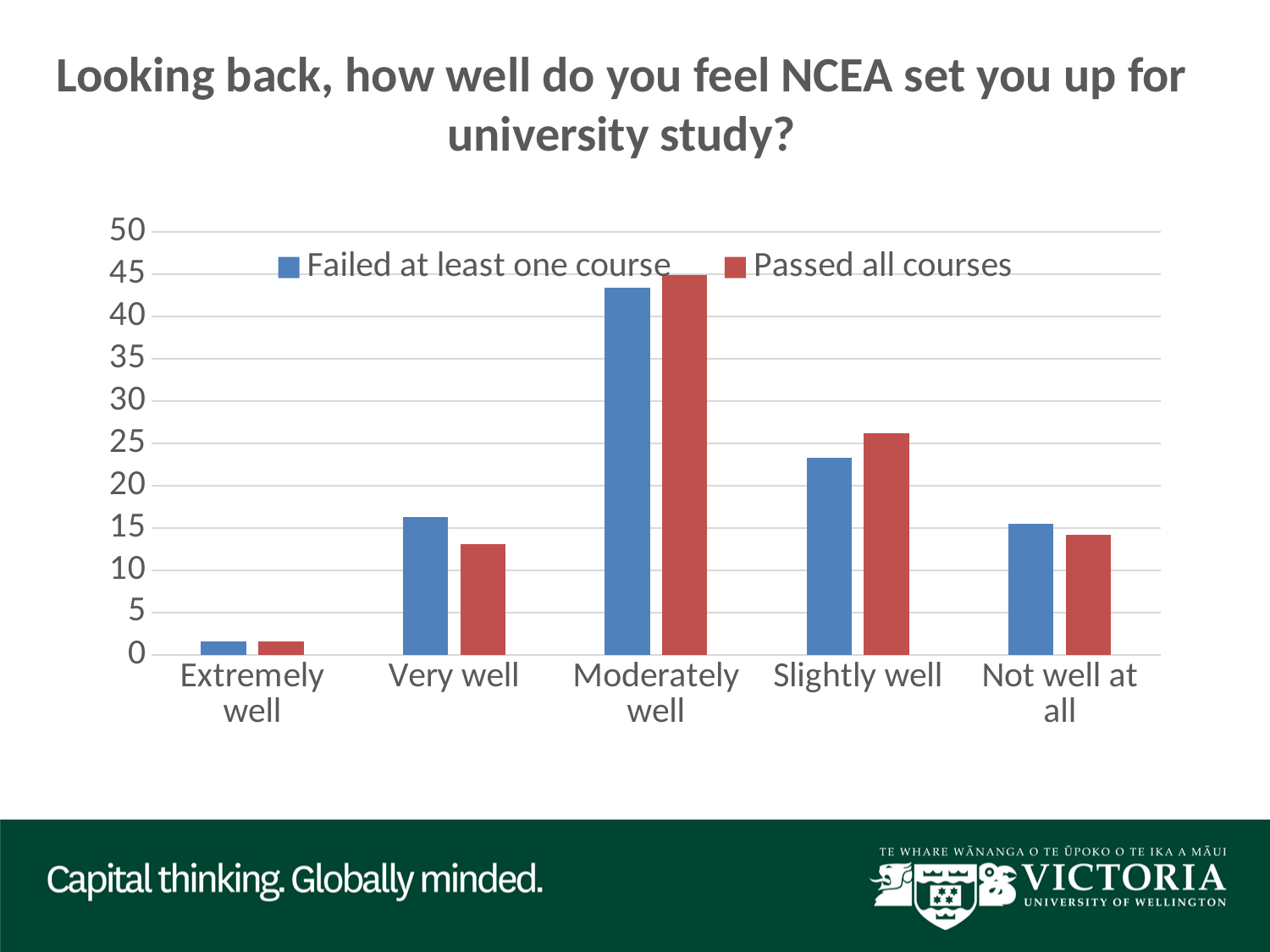
How many categories are shown on the x axis? 5 What is the title of the chart? Looking back, how well do you feel NCEA set you up for university study? Is the value for 'Failed at least one course' at 'Moderately well' greater or less than 40? greater Which category has the highest value for 'Passed all courses'? Moderately well What kind of chart is shown on the slide? bar chart For 'Slightly well', which series has the larger value: 'Failed at least one course' or 'Passed all courses'? Passed all courses For 'Very well', which series has the larger value: 'Failed at least one course' or 'Passed all courses'? Failed at least one course Which category has the highest value for 'Failed at least one course'? Moderately well Is the value for 'Failed at least one course' at 'Slightly well' greater or less than 20? greater How many series does the legend list? 2 Is the value for 'Passed all courses' at 'Very well' greater or less than 15? less Which category has the lowest value for 'Passed all courses'? Extremely well